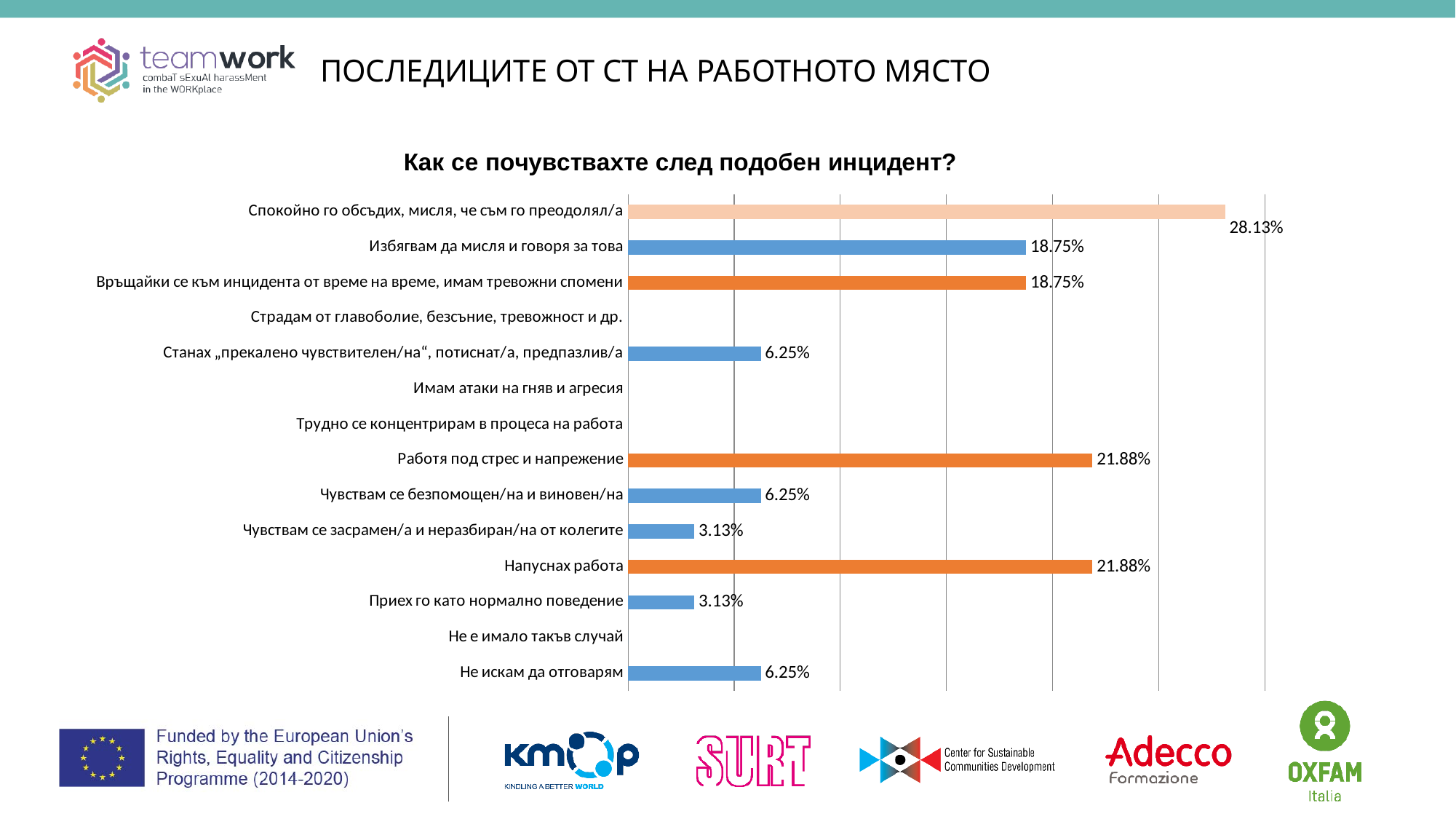
What is the value for "Избягвам да мисля и говоря за това"? 18.75% What is the title of the chart? Как се почувствахте след подобен инцидент? What is the difference between the values for "Чувствам се безпомощен/на и виновен/на" and "Приех го като нормално поведение"? 3.12% What type of chart is shown on the slide? bar chart What is the value for "Не искам да отговарям"? 6.25% How many categories are listed on the chart's vertical axis? 14 Which category has the highest value? Спокойно го обсъдих, мисля, че съм го преодолял/а What is the value for "Чувствам се засрамен/а и неразбиран/на от колегите"? 3.13% What is the value for "Напуснах работа"? 21.88% Which is larger: the value for "Работя под стрес и напрежение" or the value for "Избягвам да мисля и говоря за това"? Работя под стрес и напрежение What is the difference between the values for "Спокойно го обсъдих, мисля, че съм го преодолял/а" and "Работя под стрес и напрежение"? 6.25% What is the value for "Спокойно го обсъдих, мисля, че съм го преодолял/а"? 28.13%